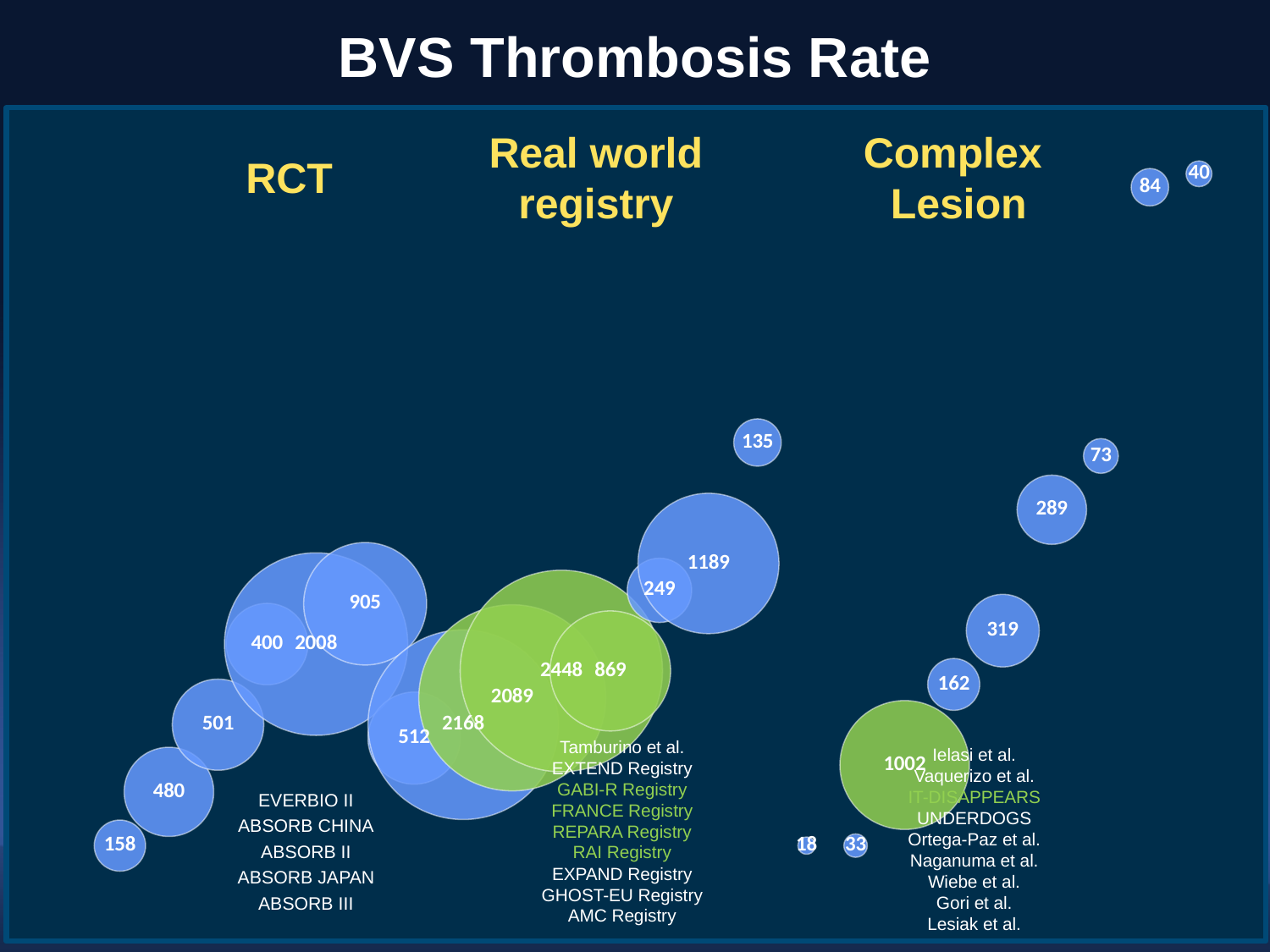
What is the largest number labelled on any bubble in the chart? 2448 Which group heading appears at the far left of the chart? RCT What kind of chart is shown on the slide? bubble chart What is the difference between the bubble labelled 2448 and the bubble labelled 2089? 359 What is the smallest number labelled on any bubble in the chart? 18 What is the title of the chart? BVS Thrombosis Rate Which is larger, the bubble labelled 1189 or the bubble labelled 905? 1189 What is the difference between the bubble labelled 501 and the bubble labelled 480? 21 What is the largest number labelled on a bubble in the Complex Lesion group? 1002 Which is larger, the bubble labelled 319 or the bubble labelled 162? 319 How many group headings are shown across the top of the chart? 3